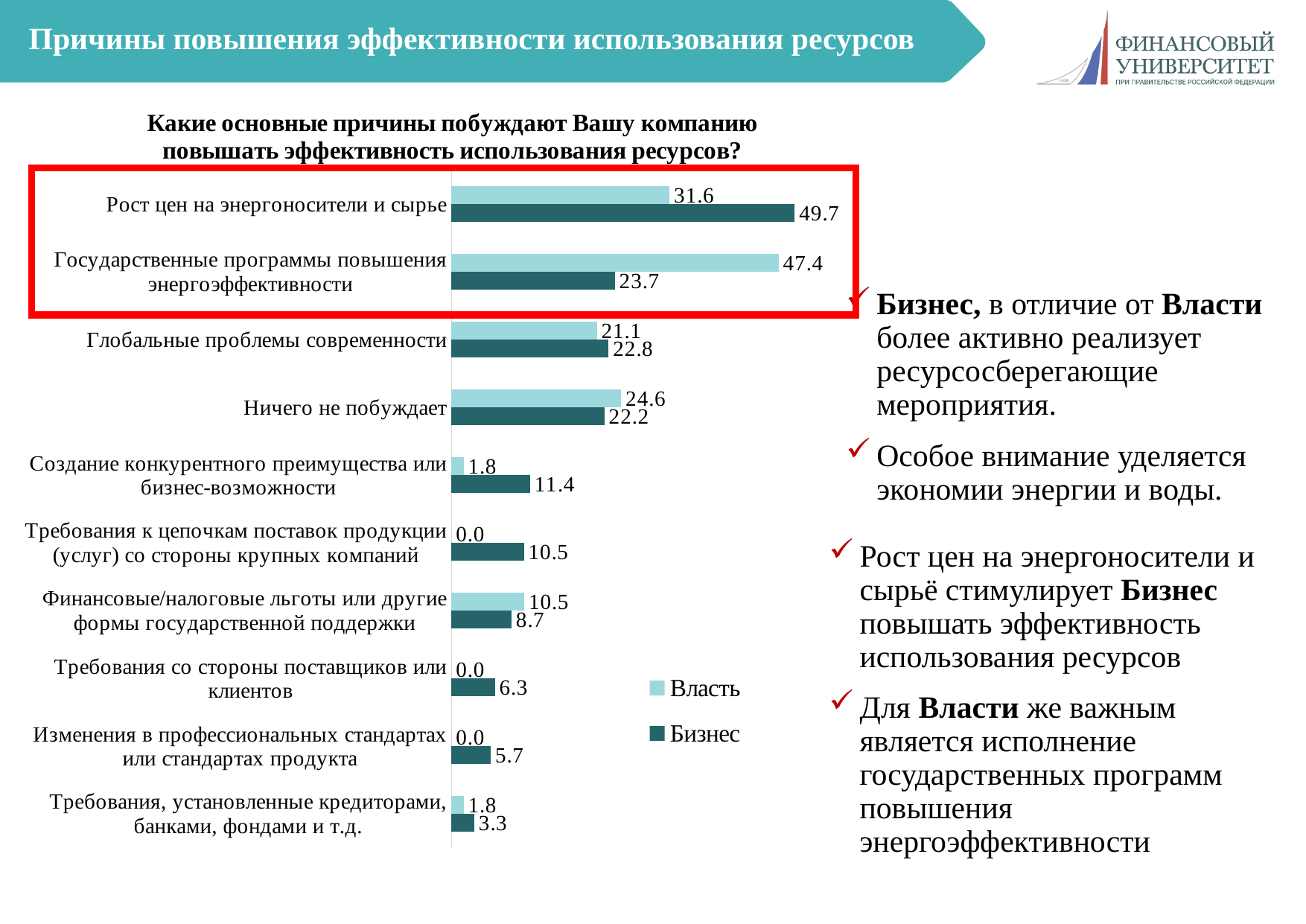
For "Создание конкурентного преимущества или бизнес-возможности", which series has the larger value, Власть or Бизнес? Бизнес What is the value for Власть for "Ничего не побуждает"? 24.6 What is the value for Власть for "Государственные программы повышения энергоэффективности"? 47.4 What is the difference between the Бизнес and Власть values for "Рост цен на энергоносители и сырье"? 18.1 How many categories are shown on the chart? 10 What type of chart is shown on the slide? Bar chart What is the value for Бизнес for "Рост цен на энергоносители и сырье"? 49.7 Which category has the highest value for the Власть series? Государственные программы повышения энергоэффективности Which series is shown in the darker colour in the legend? Бизнес Which category has the lowest value for the Бизнес series? Требования, установленные кредиторами, банками, фондами и т.д. How many series does the legend list? 2 Which category has the highest value for the Бизнес series? Рост цен на энергоносители и сырье